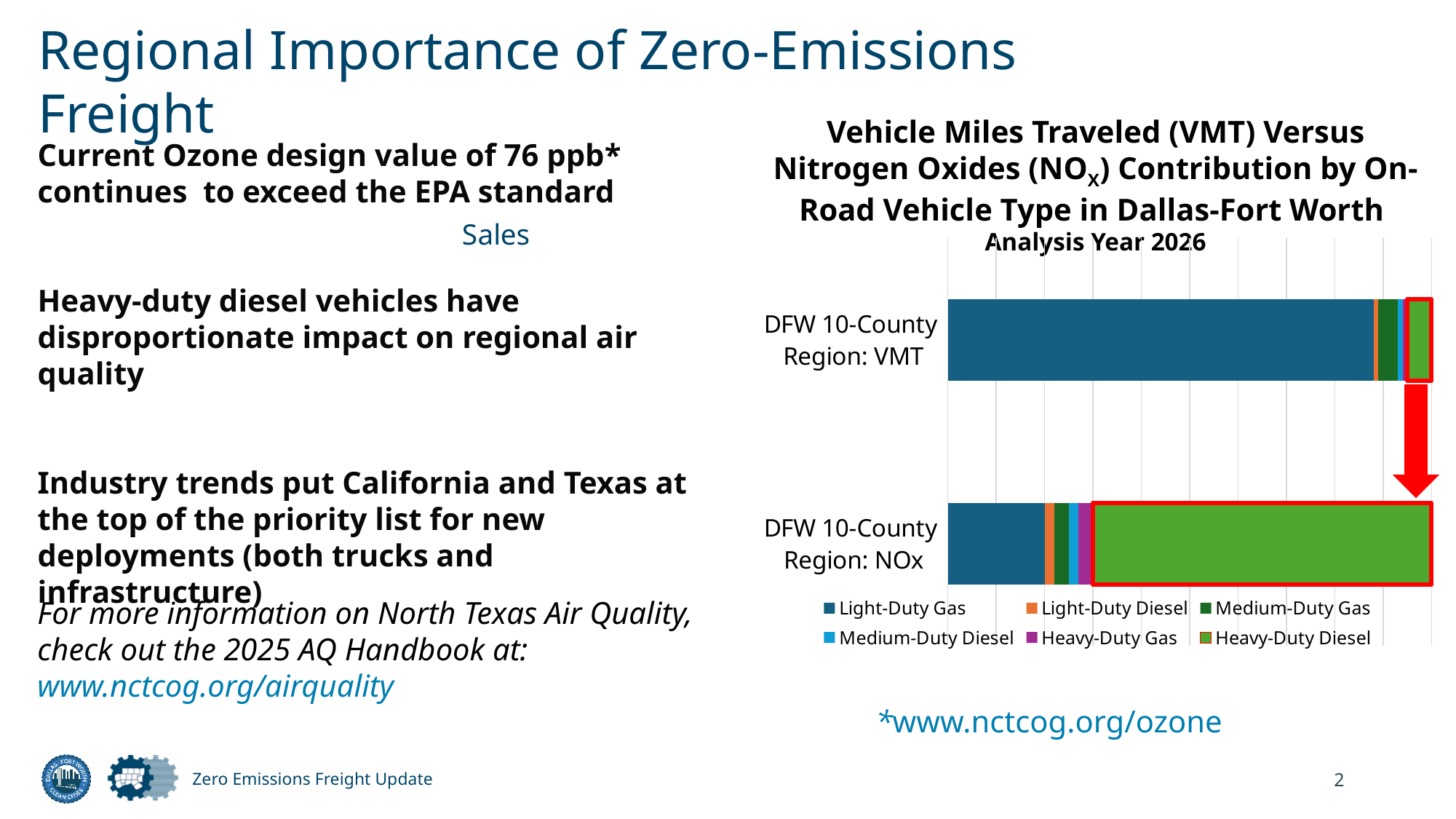
Are the bars in the chart drawn horizontally or vertically? Horizontally In the DFW 10-County Region: VMT bar, which vehicle type takes up the largest share? Light-Duty Gas How many bars (categories) does the chart show? 2 In the DFW 10-County Region: NOx bar, which vehicle type takes up the largest share? Heavy-Duty Diesel Which series is highlighted with red boxes in the chart? Heavy-Duty Diesel Is the Heavy-Duty Diesel segment larger in the VMT bar or in the NOx bar? NOx bar What analysis year does the chart subtitle give? 2026 How many series does the chart legend list? 6 What kind of chart is shown on the slide? Stacked bar chart